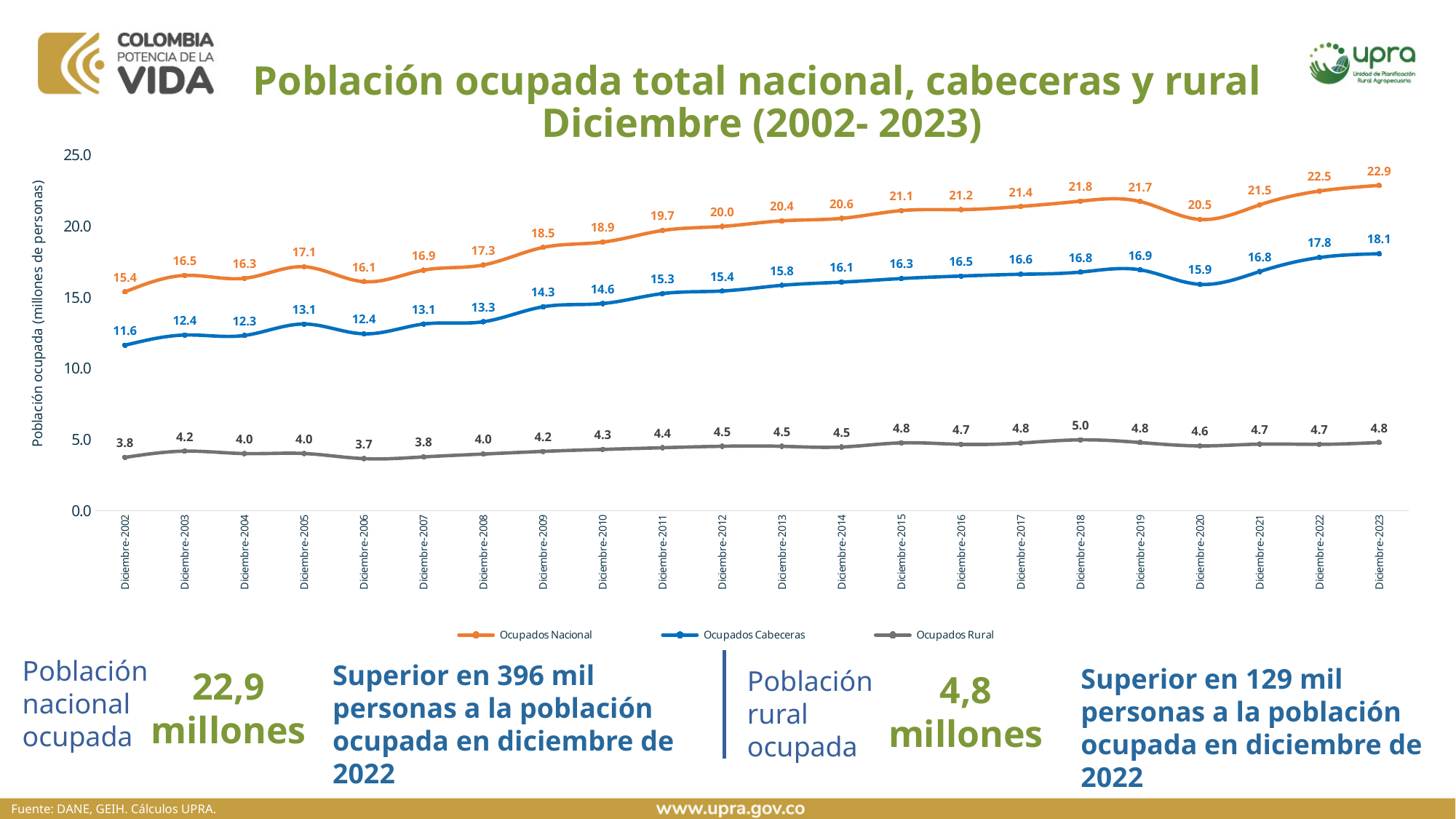
Does Ocupados Nacional generally rise or fall from Diciembre-2002 to Diciembre-2023? Rise Which is larger for Ocupados Cabeceras: Diciembre-2005 or Diciembre-2006? Diciembre-2005 What is the value of Ocupados Cabeceras in Diciembre-2020? 15.9 In which period is Ocupados Nacional at its lowest value? Diciembre-2002 In which period does Ocupados Rural reach its highest value? Diciembre-2018 What kind of chart is shown on the slide? Line chart What is the value of Ocupados Rural in Diciembre-2018? 5.0 How many time periods are plotted on the x axis? 22 In which period is Ocupados Rural at its lowest value? Diciembre-2006 What is the value of Ocupados Nacional in Diciembre-2023? 22.9 By how much did Ocupados Nacional increase from Diciembre-2022 to Diciembre-2023? 0.4 How many series does the legend list? 3